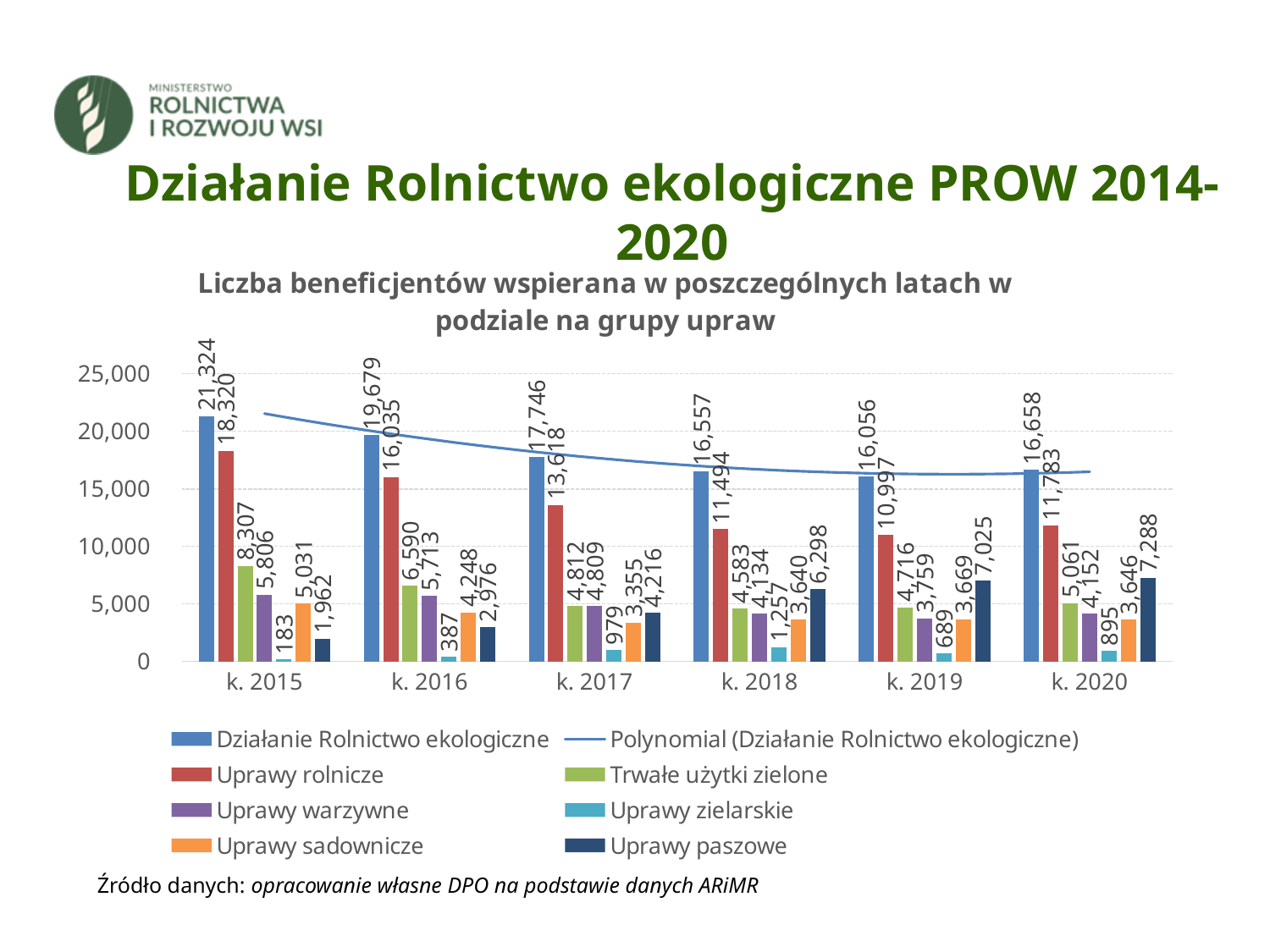
In which year is the value for Działanie Rolnictwo ekologiczne the highest? k. 2015 What kind of chart is this? bar chart What is the difference between the Uprawy rolnicze values in k. 2015 and k. 2020? 6,537 How many entries does the legend list? 8 Do the values for Uprawy paszowe rise or fall from k. 2015 to k. 2020? rise How many years (categories) are shown on the x axis? 6 In k. 2019, which is larger: Uprawy paszowe or Uprawy sadownicze? Uprawy paszowe What is the value for Trwałe użytki zielone in k. 2016? 6,590 What is the value for Uprawy paszowe in k. 2020? 7,288 In which year is the value for Uprawy zielarskie the lowest? k. 2015 What is the value for Uprawy zielarskie in k. 2018? 1,257 What is the value for Działanie Rolnictwo ekologiczne in k. 2015? 21,324